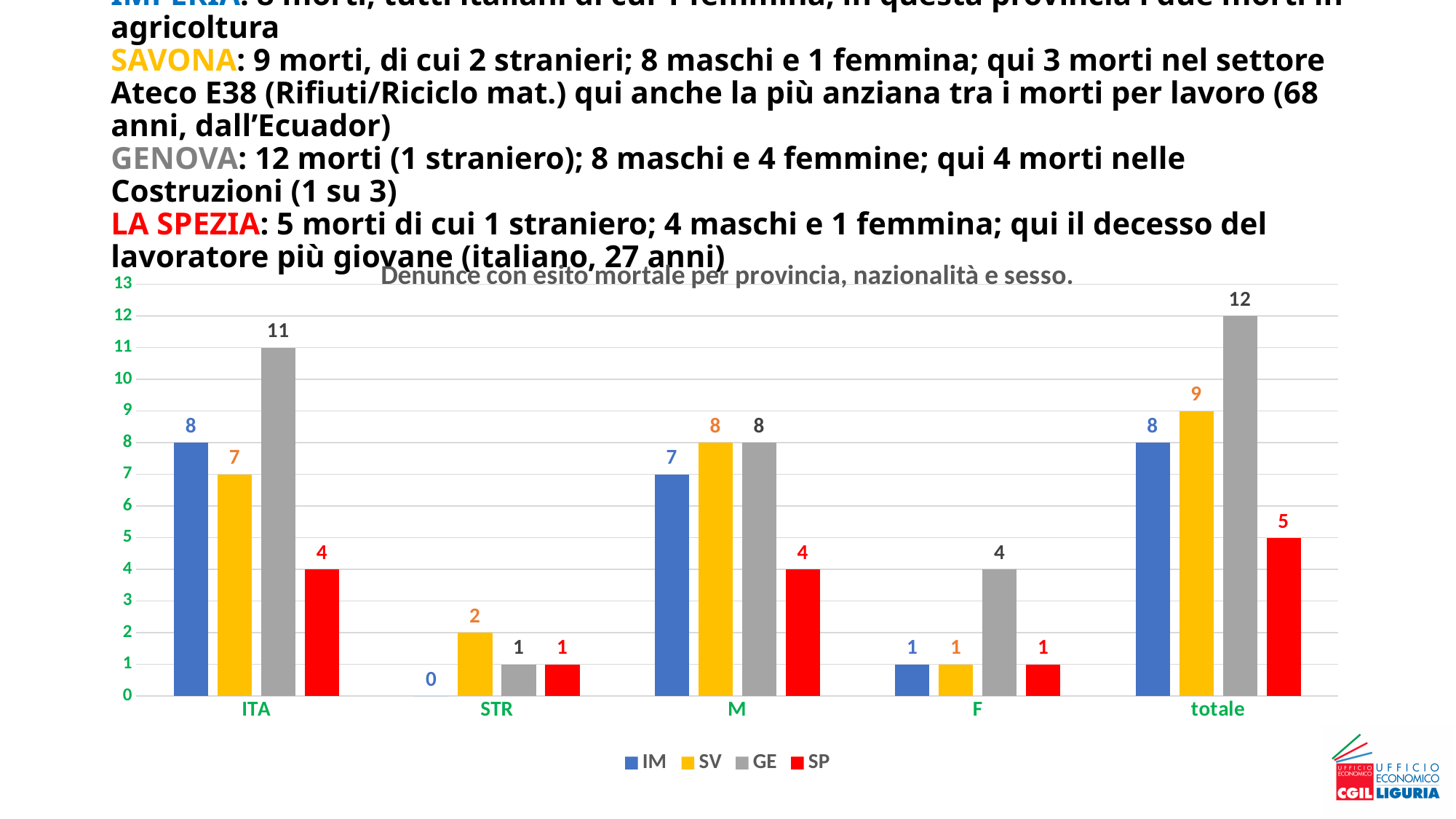
What is the value for SV in the totale category? 9 How many categories are shown on the x axis? 5 What is the value for GE in the ITA category? 11 What kind of chart is shown on the slide? bar chart How many series does the legend list? 4 Which colour represents the SP series in the chart? red Which series has the highest value in the totale category? GE In the M category, is the value for IM or SP larger? IM What is the value for IM in the STR category? 0 Which series has the lowest value in the F category? IM, SV and SP (tied at 1) What is the difference between the GE and SP values in the totale category? 7 What is the title of the chart? Denunce con esito mortale per provincia, nazionalità e sesso.